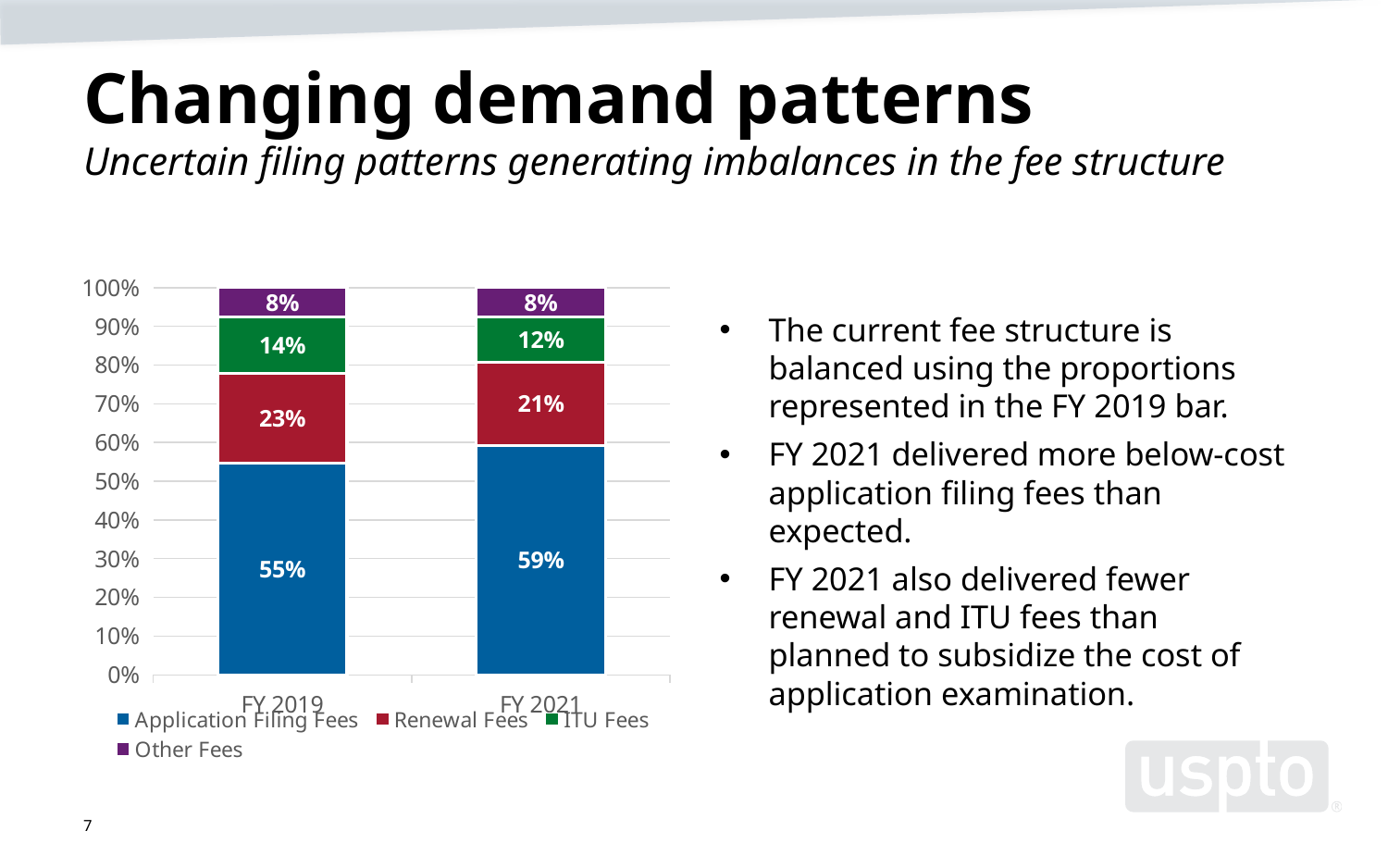
Which fee category has the largest share in FY 2021? Application Filing Fees What percentage of fees were ITU Fees in FY 2019? 14% What percentage of fees were Renewal Fees in FY 2021? 21% What percentage of fees were Other Fees in FY 2021? 8% How many series does the legend list? 4 Is the Renewal Fees share larger in FY 2019 or FY 2021? FY 2019 How many fiscal years are shown on the x axis? 2 By how many percentage points did the Application Filing Fees share change from FY 2019 to FY 2021? 4% Which fee category has the smallest share in FY 2019? Other Fees What kind of chart is shown on the slide? Stacked bar chart Does the ITU Fees share rise or fall from FY 2019 to FY 2021? Fall What percentage of fees were Application Filing Fees in FY 2019? 55%